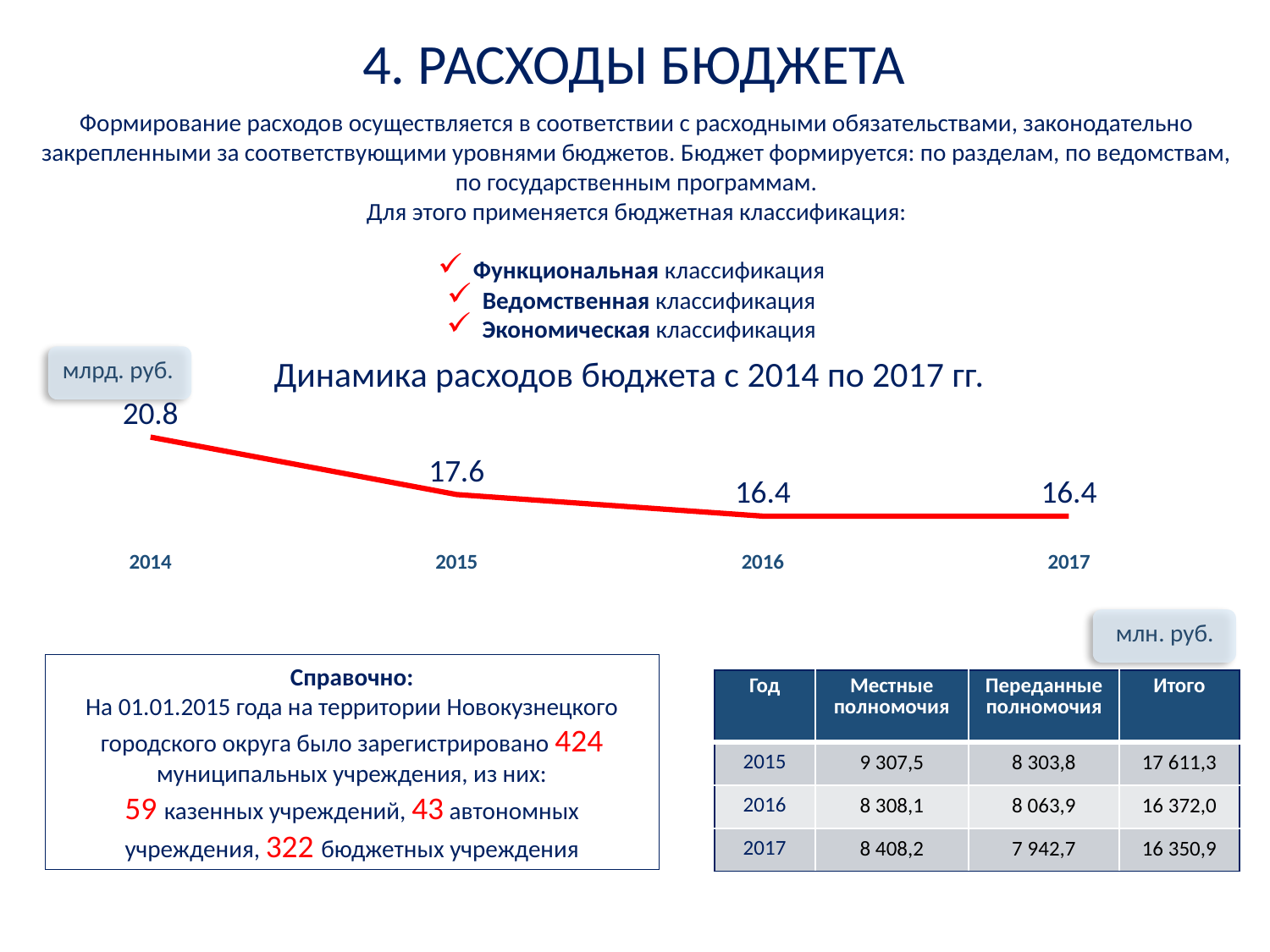
What is the value for 2015 in the chart 'Динамика расходов бюджета с 2014 по 2017 гг.'? 17.6 What colour is the line in the chart 'Динамика расходов бюджета с 2014 по 2017 гг.'? Red What is the value for 2014 in the chart 'Динамика расходов бюджета с 2014 по 2017 гг.'? 20.8 What unit is indicated for the chart 'Динамика расходов бюджета с 2014 по 2017 гг.'? млрд. руб. What type of chart is used to show the dynamics of budget expenditures from 2014 to 2017? Line chart Do the values in the chart 'Динамика расходов бюджета с 2014 по 2017 гг.' rise or fall from 2014 to 2016? Fall What is the value for 2017 in the chart 'Динамика расходов бюджета с 2014 по 2017 гг.'? 16.4 How many years are plotted in the chart 'Динамика расходов бюджета с 2014 по 2017 гг.'? 4 What is the difference between the 2014 and 2015 values in the chart 'Динамика расходов бюджета с 2014 по 2017 гг.'? 3.2 What is the difference between the 2015 and 2016 values in the chart 'Динамика расходов бюджета с 2014 по 2017 гг.'? 1.2 Which is larger in the chart 'Динамика расходов бюджета с 2014 по 2017 гг.': the value for 2014 or the value for 2016? 2014 Which year has the highest value in the chart 'Динамика расходов бюджета с 2014 по 2017 гг.'? 2014